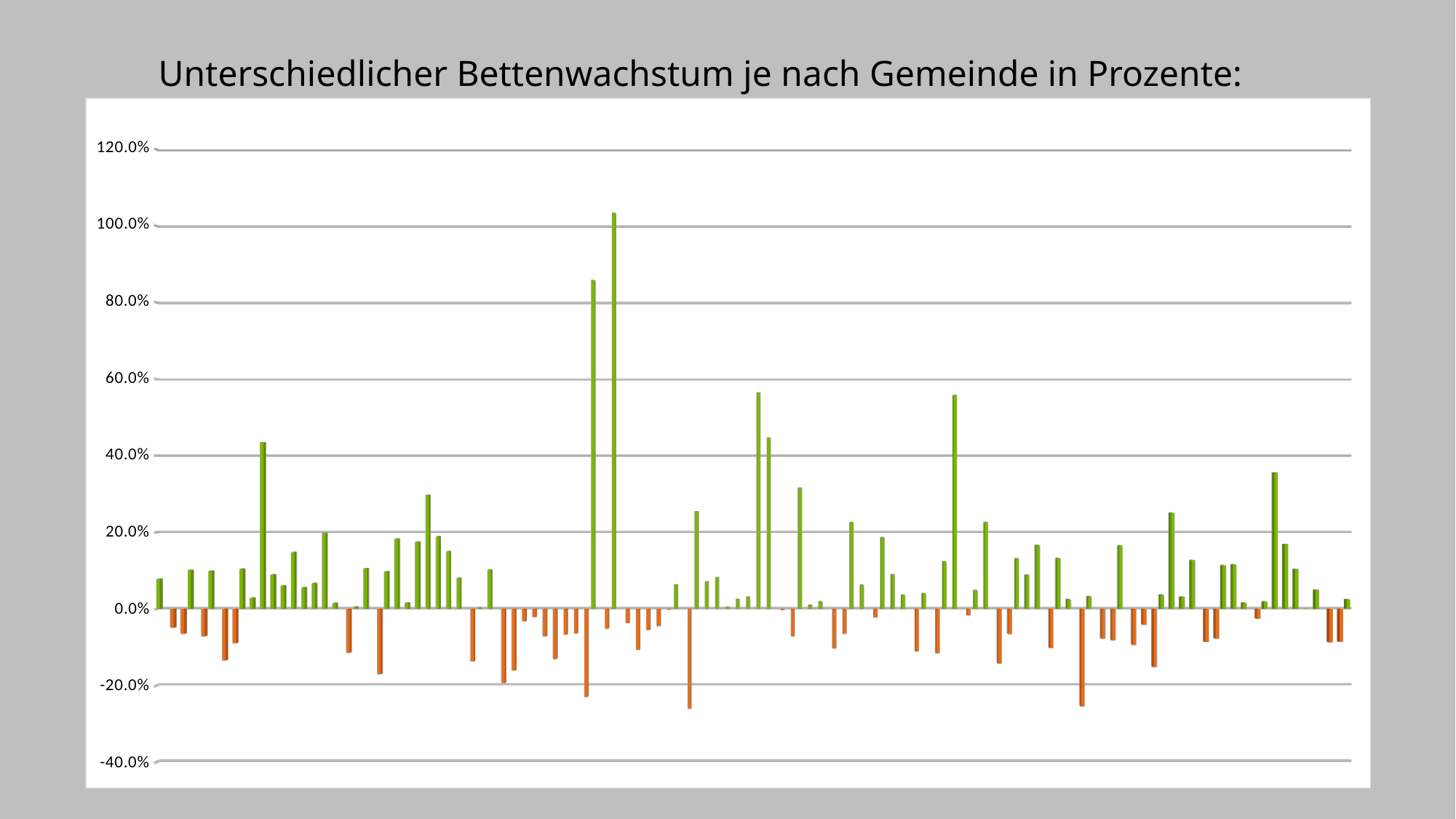
Is the value of the tallest bar in the chart greater or less than 100%? greater Is the value of the second-tallest bar in the chart greater or less than 80%? greater What is the highest value shown on the vertical axis? 120.0% Is the value of the lowest (most negative) bar in the chart greater or less than -20%? less What kind of chart is shown on the slide? bar chart What is the title of the chart? Unterschiedlicher Bettenwachstum je nach Gemeinde in Prozente: